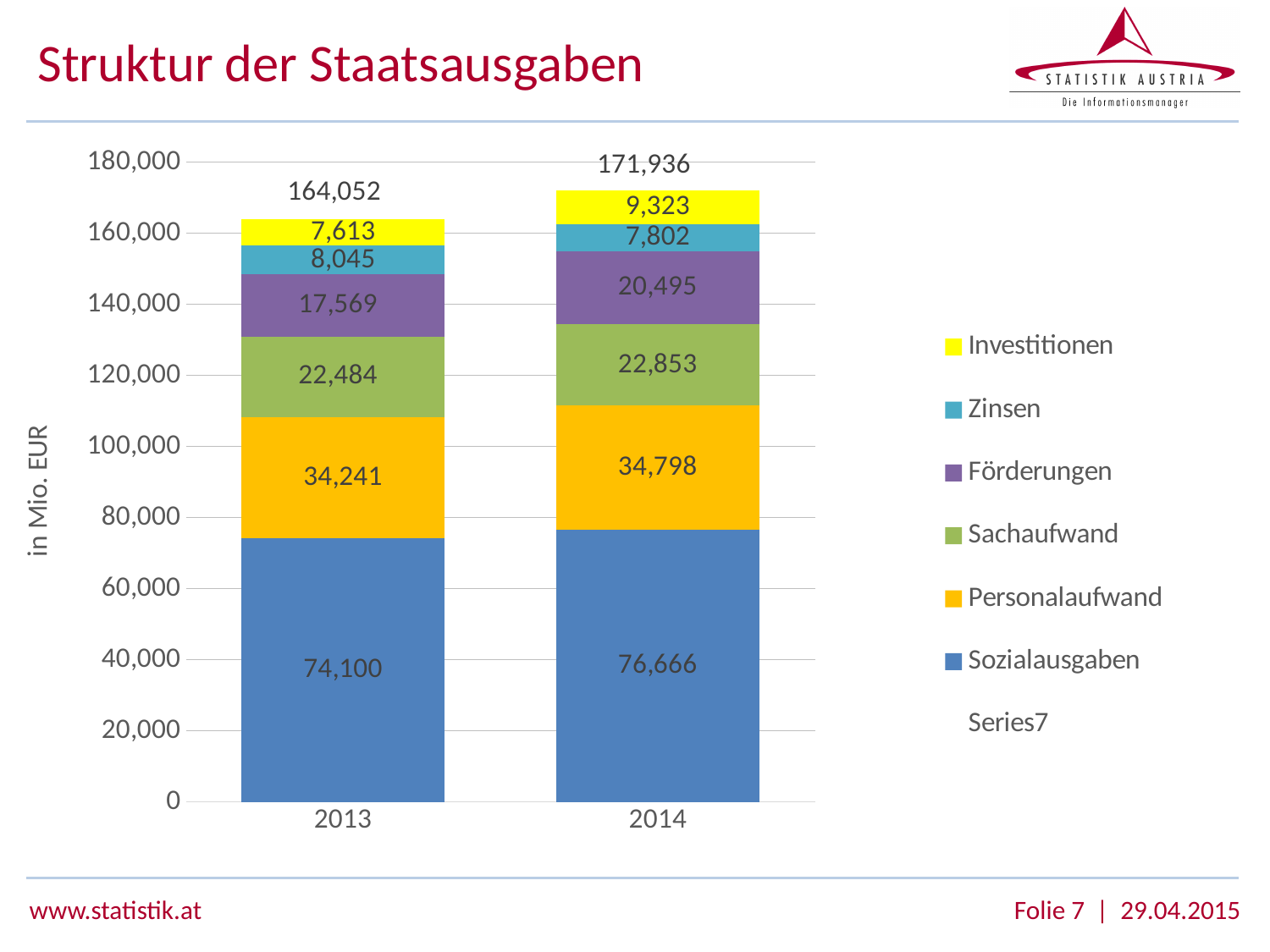
What is the value for Förderungen in 2014? 20,495 Which series is the largest component of the 2014 bar? Sozialausgaben Which year has the larger value for Zinsen, 2013 or 2014? 2013 What is the total of the stacked bar for 2013? 164,052 How many entries does the legend list? 7 What is the value for Sozialausgaben in 2013? 74,100 What kind of chart is shown on the slide? Stacked bar chart How many years are shown on the x axis? 2 What is the difference between Sozialausgaben in 2014 and in 2013? 2,566 What is the difference between the total for 2014 and the total for 2013? 7,884 What is the value for Investitionen in 2014? 9,323 What is the total of the stacked bar for 2014? 171,936